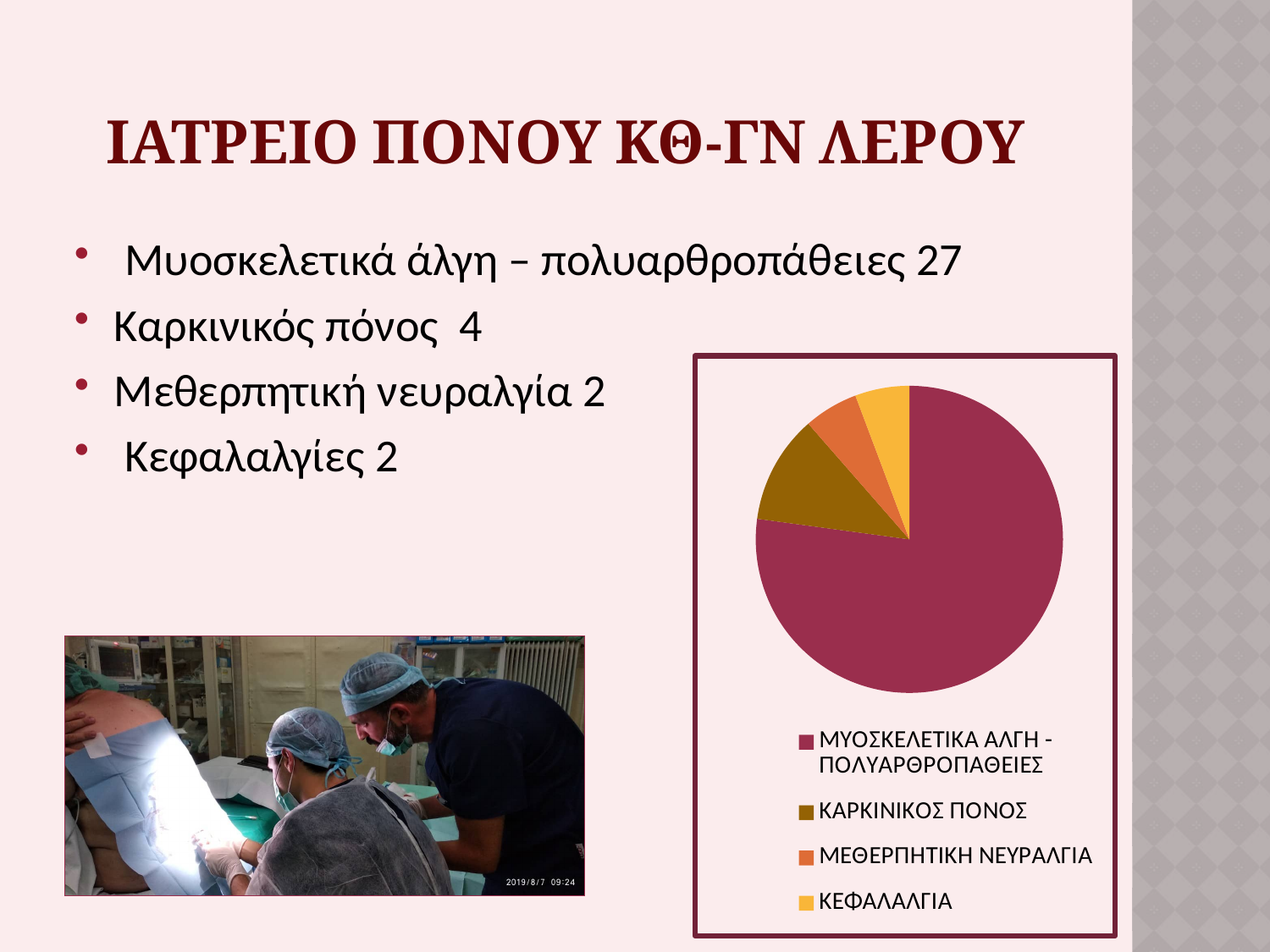
What kind of chart is shown on the slide? pie chart Does the largest slice of the pie chart take up more or less than half of the pie? more Which slice is larger in the pie chart, ΚΑΡΚΙΝΙΚΟΣ ΠΟΝΟΣ or ΚΕΦΑΛΑΛΓΙΑ? ΚΑΡΚΙΝΙΚΟΣ ΠΟΝΟΣ Which slice is larger in the pie chart, ΜΥΟΣΚΕΛΕΤΙΚΑ ΑΛΓΗ - ΠΟΛΥΑΡΘΡΟΠΑΘΕΙΕΣ or ΚΑΡΚΙΝΙΚΟΣ ΠΟΝΟΣ? ΜΥΟΣΚΕΛΕΤΙΚΑ ΑΛΓΗ - ΠΟΛΥΑΡΘΡΟΠΑΘΕΙΕΣ Which legend entry is listed first in the pie chart's legend? ΜΥΟΣΚΕΛΕΤΙΚΑ ΑΛΓΗ - ΠΟΛΥΑΡΘΡΟΠΑΘΕΙΕΣ Which category has the largest slice in the pie chart? ΜΥΟΣΚΕΛΕΤΙΚΑ ΑΛΓΗ - ΠΟΛΥΑΡΘΡΟΠΑΘΕΙΕΣ How many entries does the legend of the pie chart list? 4 Which slice is larger in the pie chart, ΚΑΡΚΙΝΙΚΟΣ ΠΟΝΟΣ or ΜΕΘΕΡΠΗΤΙΚΗ ΝΕΥΡΑΛΓΙΑ? ΚΑΡΚΙΝΙΚΟΣ ΠΟΝΟΣ How many slices does the pie chart have? 4 Which legend entry is shown in yellow in the pie chart? ΚΕΦΑΛΑΛΓΙΑ